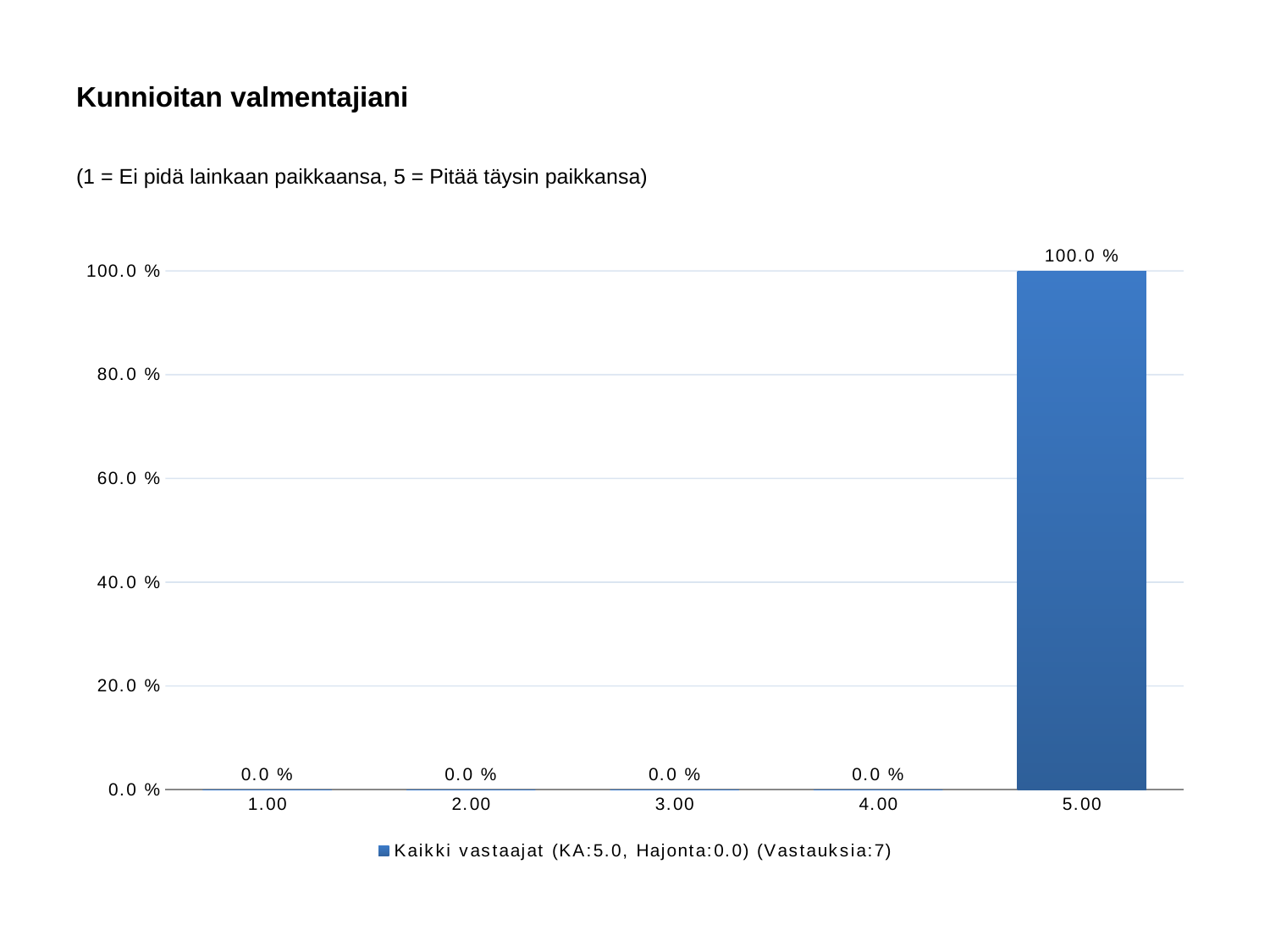
What kind of chart is shown? bar chart Which is larger, the value for 5.00 or the value for 2.00? 5.00 Which category has the highest value? 5.00 Is the value for 5.00 greater or less than 80.0 %? greater What is the difference between the values for 5.00 and 4.00? 100.0 % What is the value for category 5.00? 100.0 % What is the legend entry for the series? Kaikki vastaajat (KA:5.0, Hajonta:0.0) (Vastauksia:7) What is the value for category 3.00? 0.0 % What is the title of the slide? Kunnioitan valmentajiani How many series does the legend list? 1 What is the value for category 1.00? 0.0 % How many categories are shown on the x axis? 5